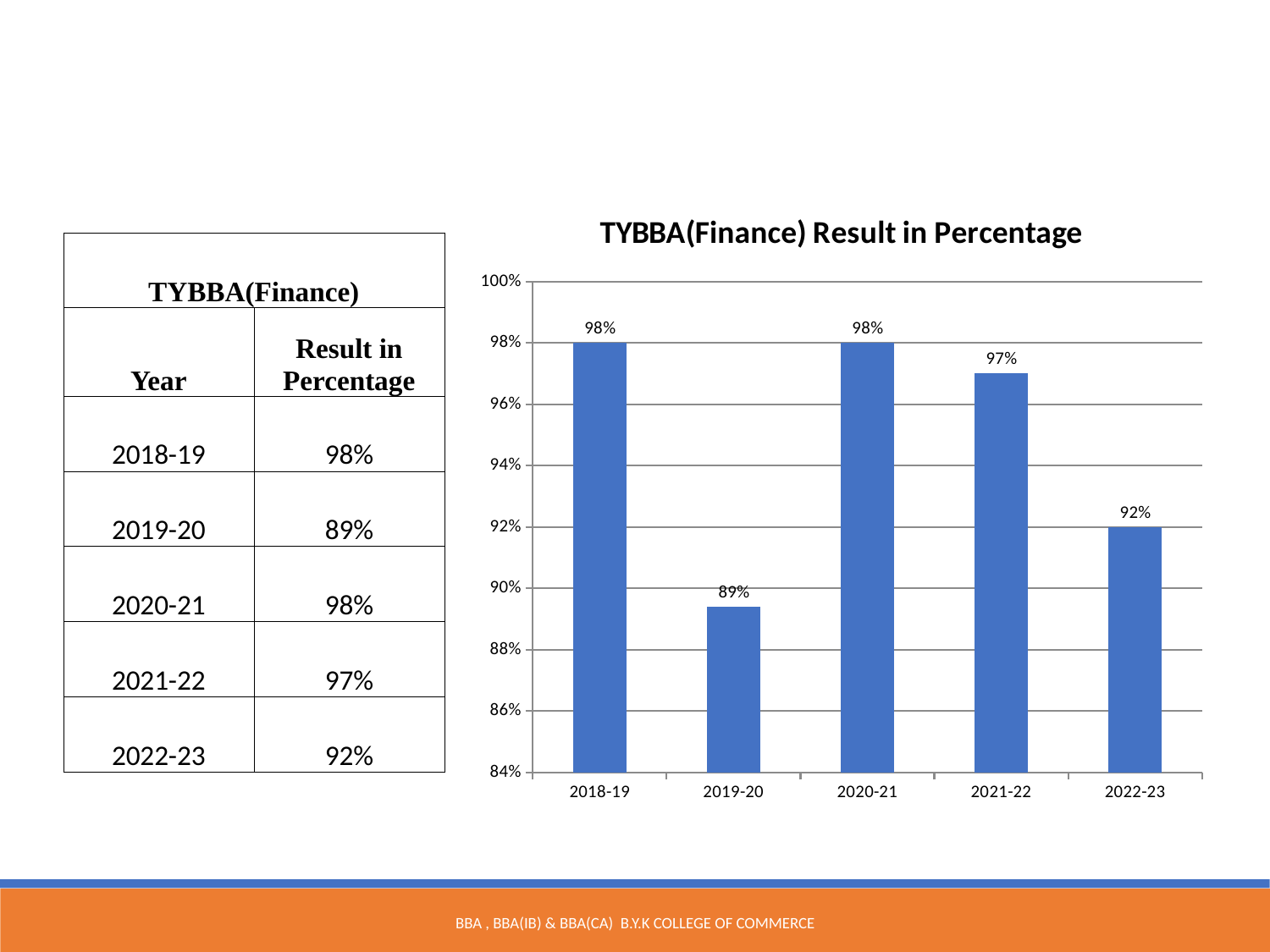
What is the result percentage for 2022-23? 92% What is the result percentage for 2021-22? 97% What is the difference between the result percentages for 2021-22 and 2022-23? 5% Which year has the lowest result percentage? 2019-20 What is the difference between the result percentages for 2018-19 and 2019-20? 9% Which is larger, the result percentage for 2021-22 or for 2022-23? 2021-22 What is the title of the chart? TYBBA(Finance) Result in Percentage How many years are shown on the chart? 5 What kind of chart is shown on the slide? Bar chart What is the result percentage for 2019-20? 89% Is the value for 2019-20 greater or less than 90%? less What is the result percentage for 2018-19? 98%